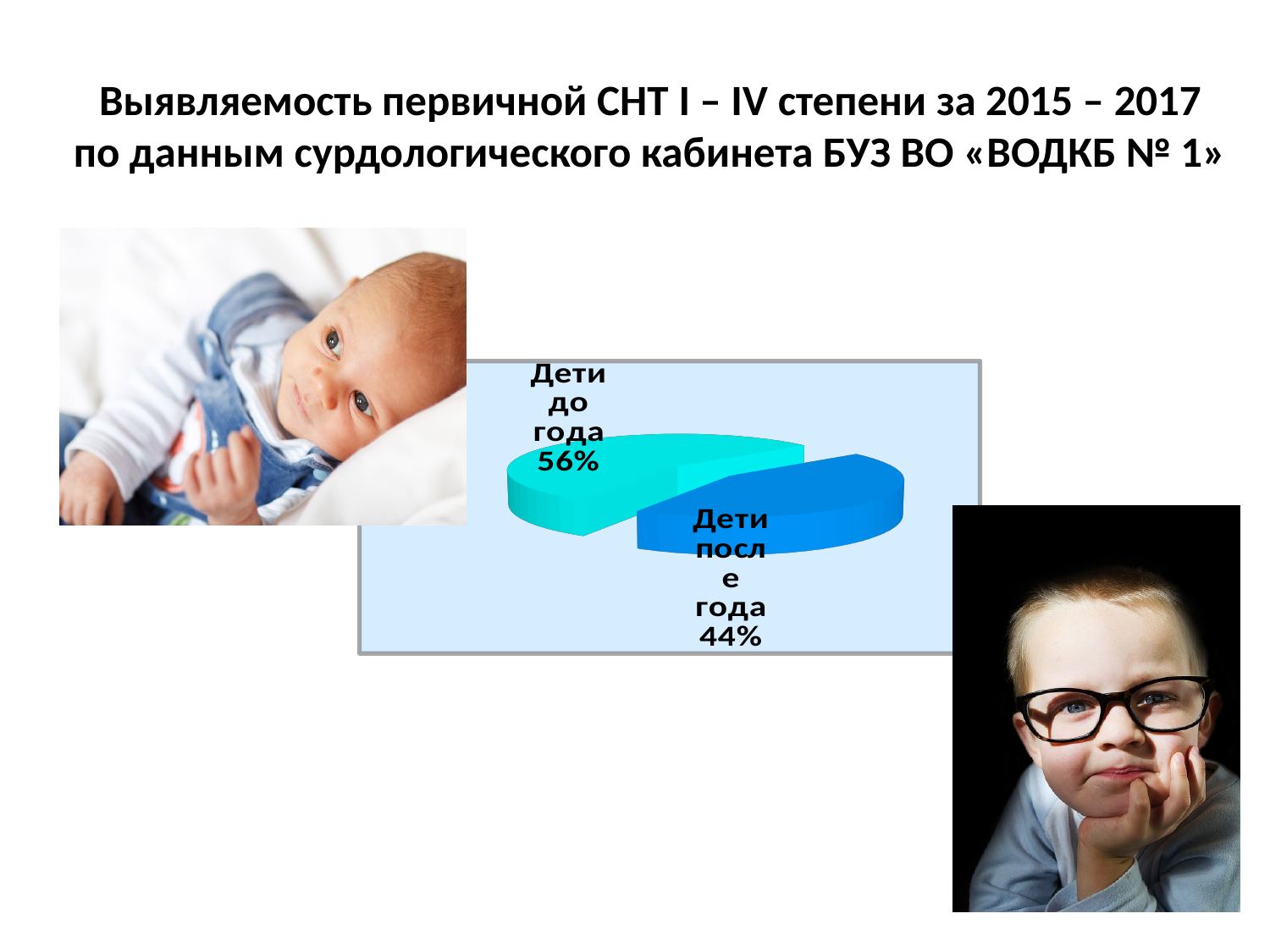
How many slices does the pie chart have? 2 What share of the pie does "Дети до года" have? 56% Is the share for "Дети до года" greater or less than 50%? greater What kind of chart is shown on the slide? pie chart What is the difference in percentage points between "Дети до года" and "Дети после года"? 12 What share of the pie does "Дети после года" have? 44% Which slice of the pie is the largest? Дети до года What is the total of the two slices shown in the pie chart? 100% Which is larger: the share for "Дети до года" or for "Дети после года"? Дети до года Which slice of the pie is the smallest? Дети после года What colour is the slice for "Дети после года"? blue